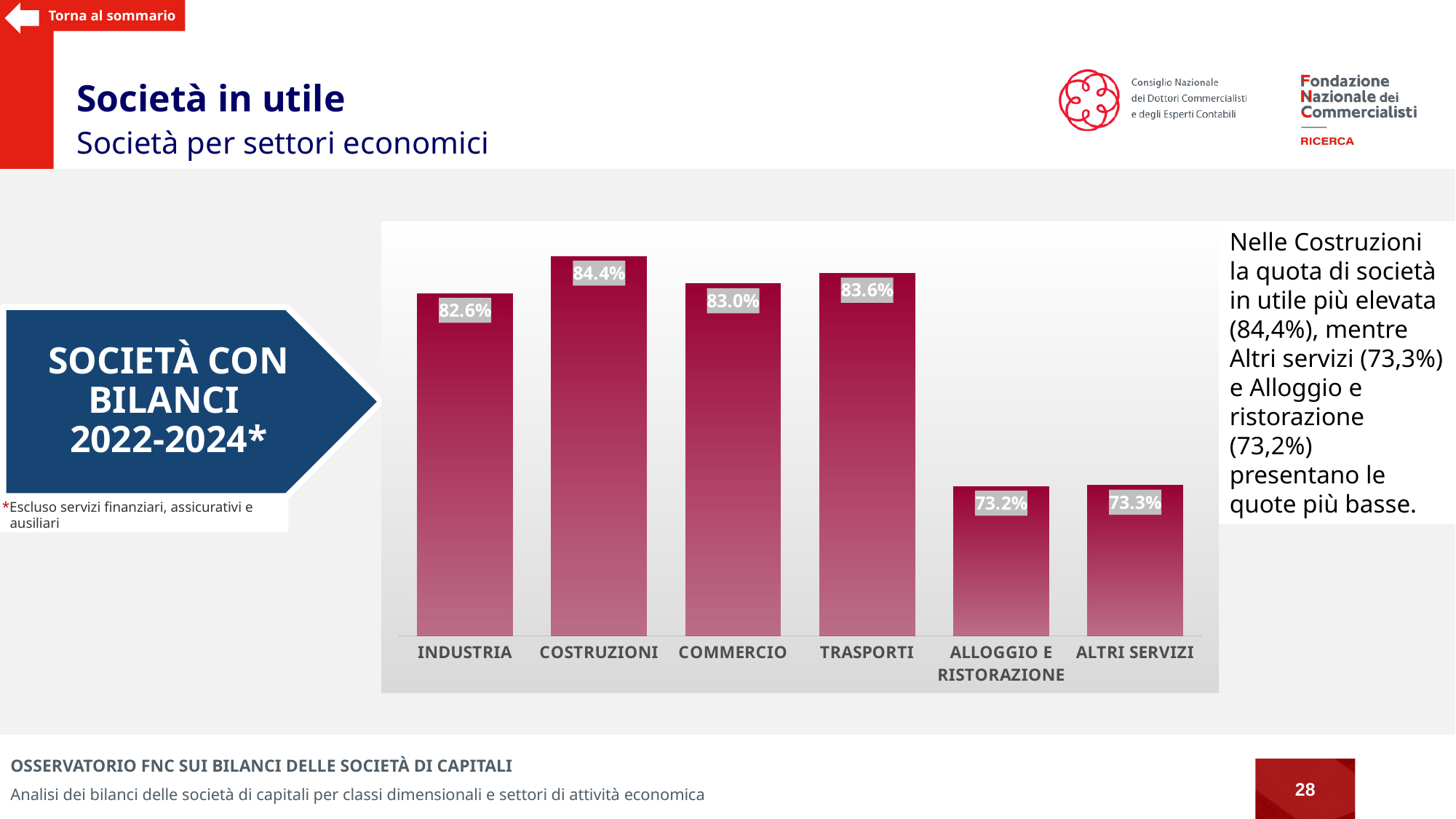
What is the value for COSTRUZIONI? 84.4% Which is larger, the value for COSTRUZIONI or the value for TRASPORTI? COSTRUZIONI What is the difference between the values for COSTRUZIONI and INDUSTRIA? 1.8% What is the value for TRASPORTI? 83.6% What is the difference between the values for COMMERCIO and ALLOGGIO E RISTORAZIONE? 9.8% What is the value for ALTRI SERVIZI? 73.3% What kind of chart is shown on the slide? Bar chart Which category has the highest value? COSTRUZIONI What is the value for INDUSTRIA? 82.6% What is the subtitle of the slide above the chart? Società per settori economici How many categories are shown on the x axis? 6 What is the value for ALLOGGIO E RISTORAZIONE? 73.2%